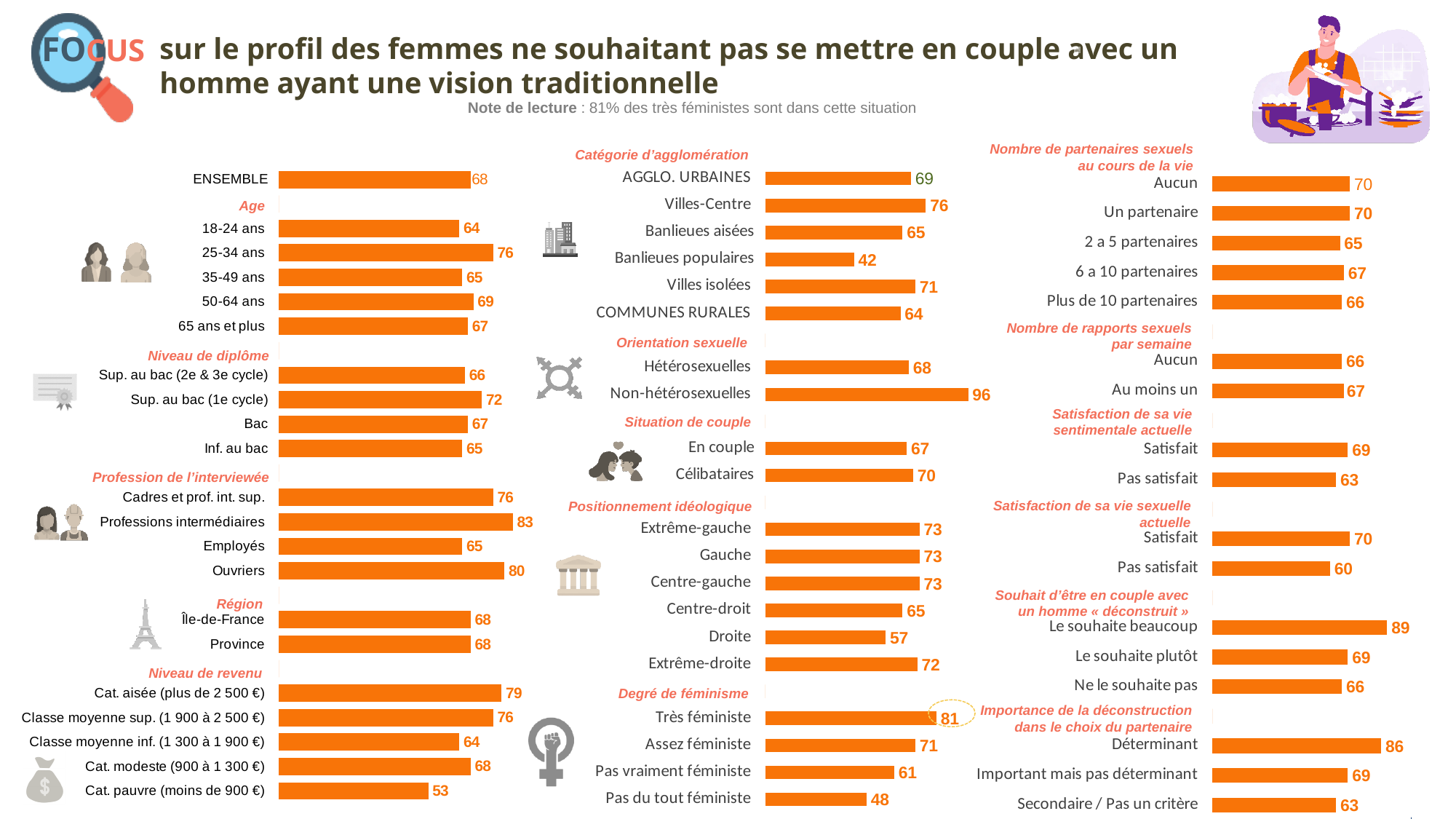
In the middle column chart, under Degré de féminisme, do the values rise or fall from Très féministe to Pas du tout féministe? fall In the middle column chart, under Positionnement idéologique, which is larger: Droite or Extrême-droite? Extrême-droite In the right column chart, what is the value for Le souhaite beaucoup? 89 In the middle column chart, what is the value for Non-hétérosexuelles? 96 What type of chart is used on this slide? bar chart In the left column chart, under Niveau de revenu, which category has the lowest value? Cat. pauvre (moins de 900 €) In the left column chart, under Profession de l'interviewée, which category has the highest value? Professions intermédiaires In the left column chart, what is the value for ENSEMBLE? 68 In the right column chart, under Importance de la déconstruction dans le choix du partenaire, which category has the highest value? Déterminant How many categories are listed under Age in the left column chart? 5 In the middle column chart, under Catégorie d'agglomération, what is the difference between Villes-Centre and Banlieues populaires? 34 In the right column chart, what is the difference between Satisfait and Pas satisfait under Satisfaction de sa vie sexuelle actuelle? 10